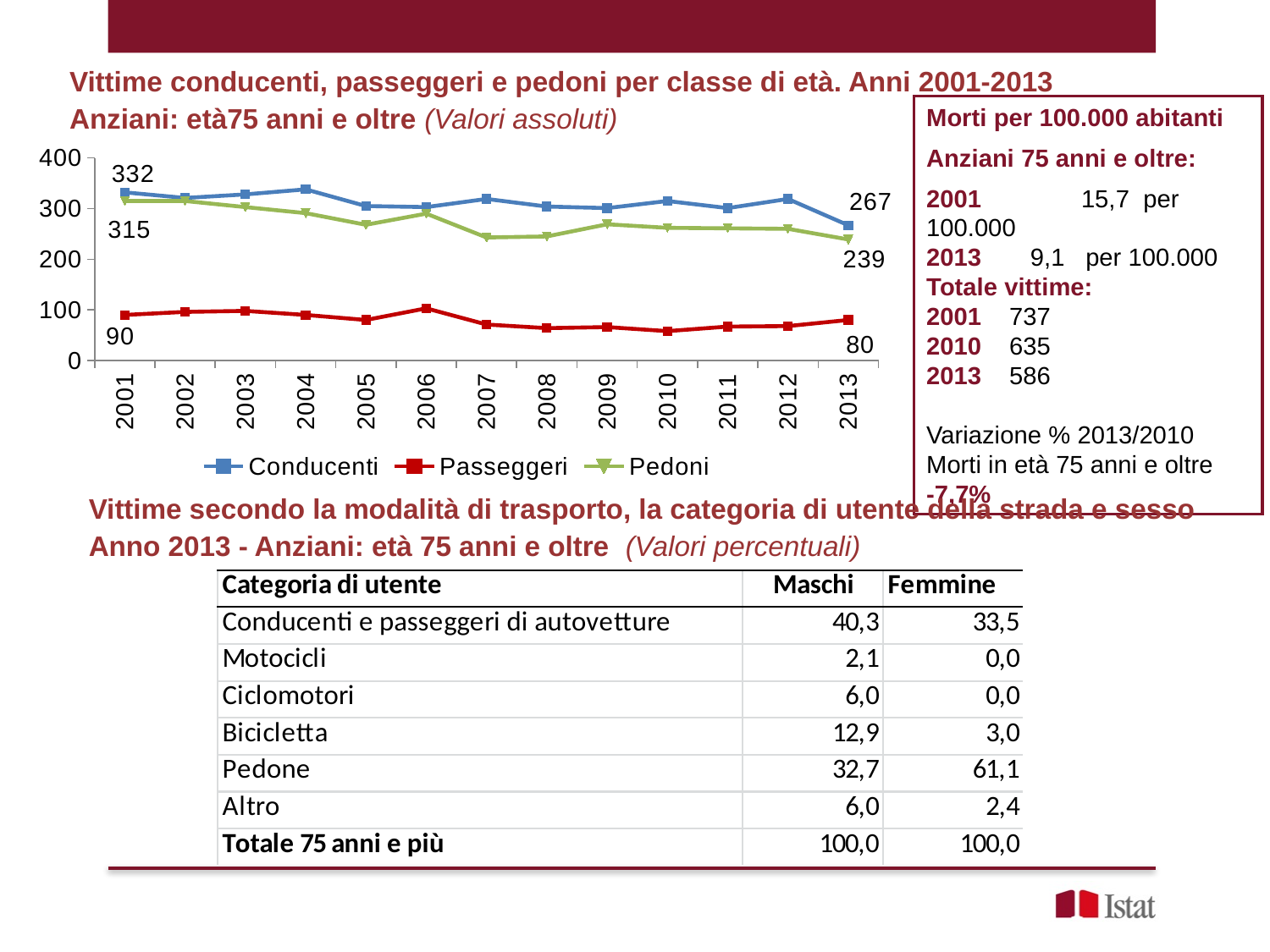
How many series does the legend list? 3 How many years are shown on the x axis? 13 What is the difference between Conducenti and Pedoni in 2013? 28 Which series has the lowest value in 2013? Passeggeri What is the value for Conducenti in 2001? 332 What kind of chart is shown? line chart What is the value for Conducenti in 2013? 267 Is the value for Pedoni in 2007 greater or less than 300? less Which is larger in 2001, Conducenti or Pedoni? Conducenti By how much did the Conducenti value fall from 2001 to 2013? 65 What is the value for Pedoni in 2013? 239 What is the value for Passeggeri in 2001? 90